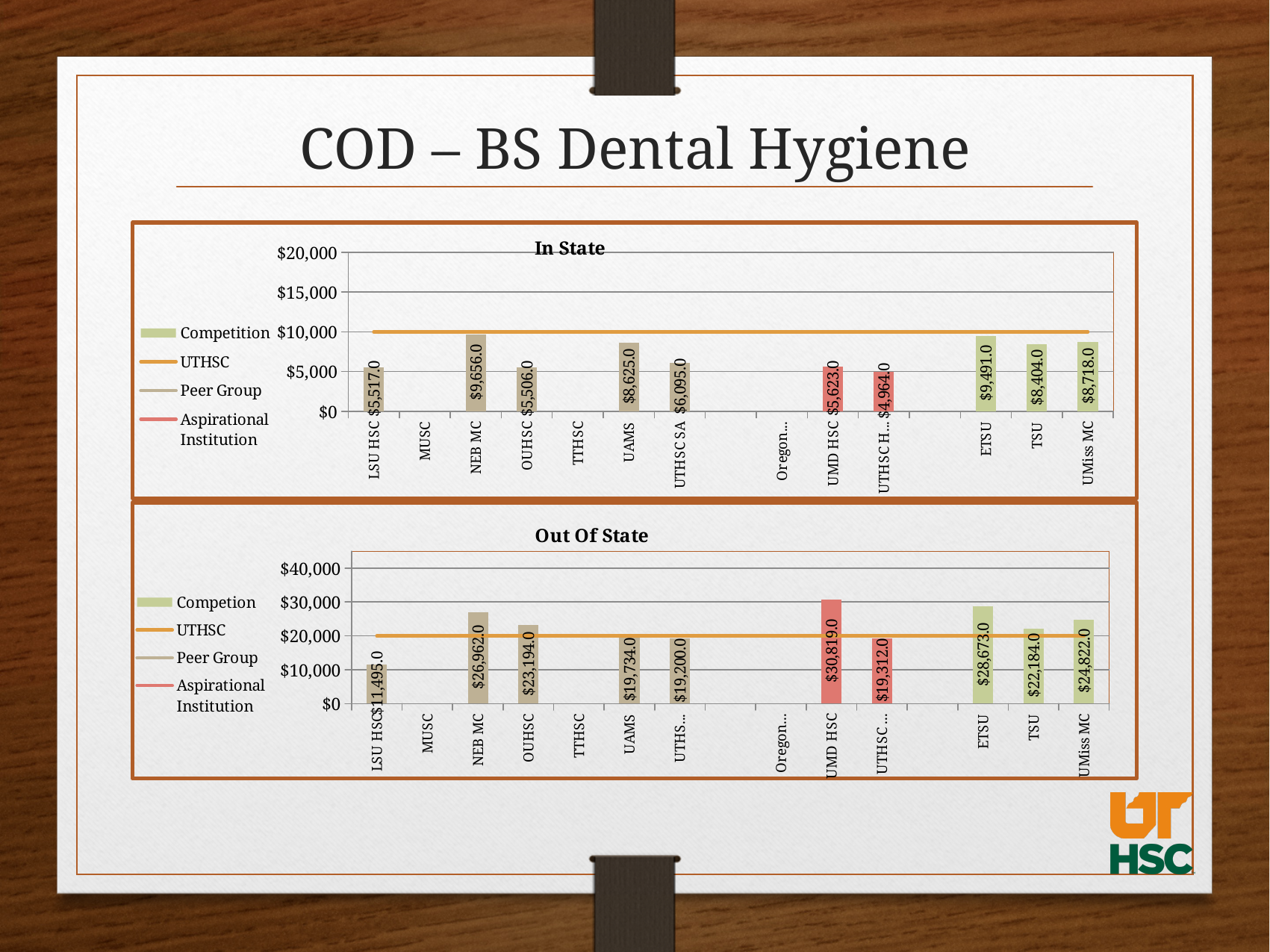
On the Out Of State chart, which institution has the lowest value? LSU HSC On the Out Of State chart, what colour are the Aspirational Institution bars? red On the In State chart, which institution has the lowest labeled value? UTHSC H... How many entries does the legend of the In State chart list? 4 On the Out Of State chart, is the value for LSU HSC greater or less than $20,000? less On the Out Of State chart, which institution has the highest value? UMD HSC On the Out Of State chart, what is the value for UMD HSC? $30,819.0 On the In State chart, which is larger, the value for UAMS or the value for UTHSC SA? UAMS What kind of chart is the Out Of State chart? bar chart On the In State chart, what is the value for NEB MC? $9,656.0 On the In State chart, what is the difference between NEB MC and LSU HSC? $4,139.0 On the Out Of State chart, what is the difference between UMD HSC and ETSU? $2,146.0